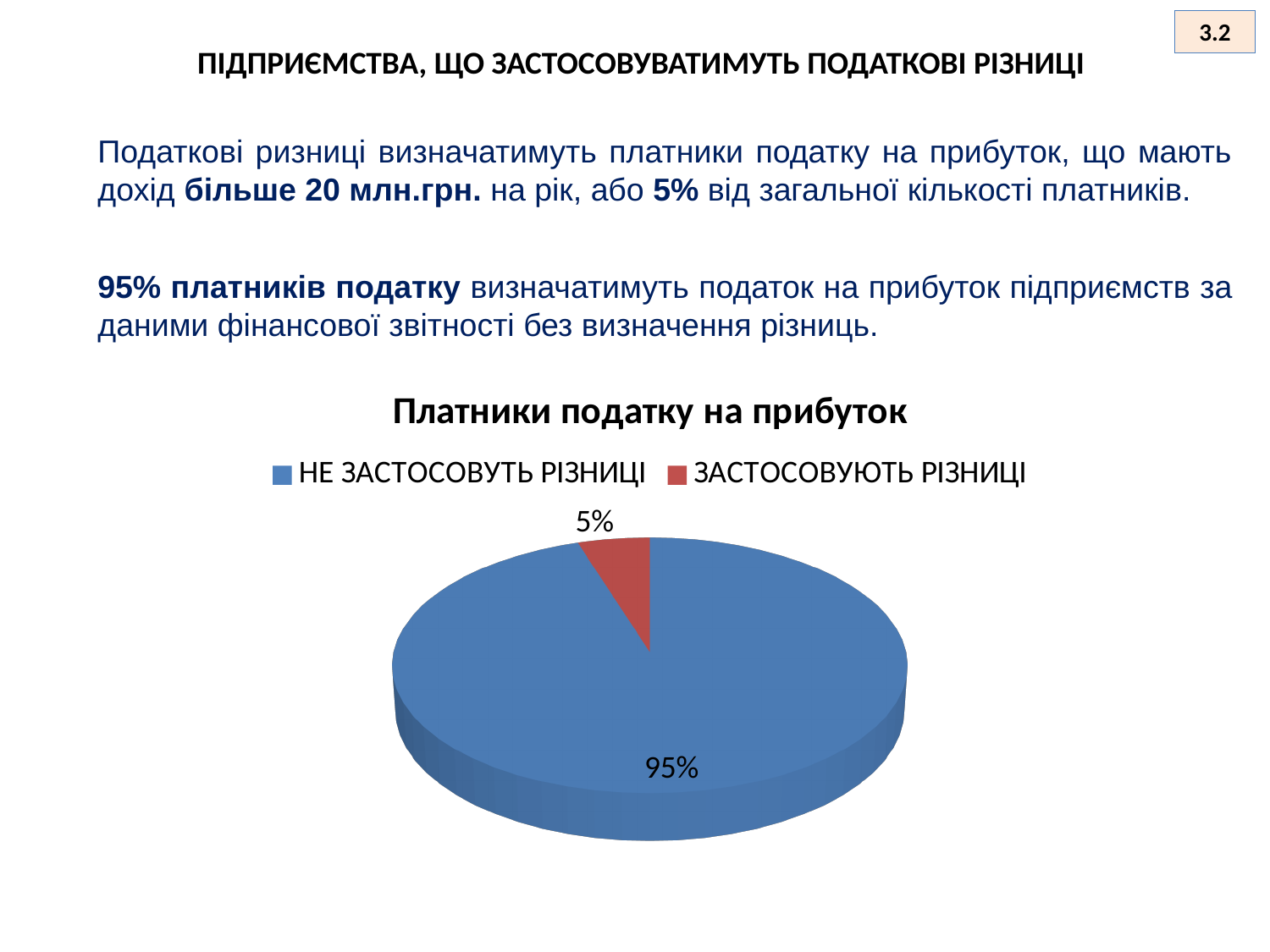
What share of the pie does the slice 'ЗАСТОСОВУЮТЬ РІЗНИЦІ' represent? 5% How many slices does the pie chart have? 2 What share of the pie does the slice 'НЕ ЗАСТОСОВУТЬ РІЗНИЦІ' represent? 95% Which slice of the pie is the smallest? ЗАСТОСОВУЮТЬ РІЗНИЦІ Which is larger: the 'ЗАСТОСОВУЮТЬ РІЗНИЦІ' slice or the 'НЕ ЗАСТОСОВУТЬ РІЗНИЦІ' slice? НЕ ЗАСТОСОВУТЬ РІЗНИЦІ What colour is the slice labelled 'ЗАСТОСОВУЮТЬ РІЗНИЦІ'? Red How many entries does the legend list? 2 What is the title of the chart? Платники податку на прибуток What type of chart is shown on the slide? Pie chart Which slice of the pie is the largest? НЕ ЗАСТОСОВУТЬ РІЗНИЦІ What is the difference in percentage points between the 'НЕ ЗАСТОСОВУТЬ РІЗНИЦІ' slice and the 'ЗАСТОСОВУЮТЬ РІЗНИЦІ' slice? 90 percentage points